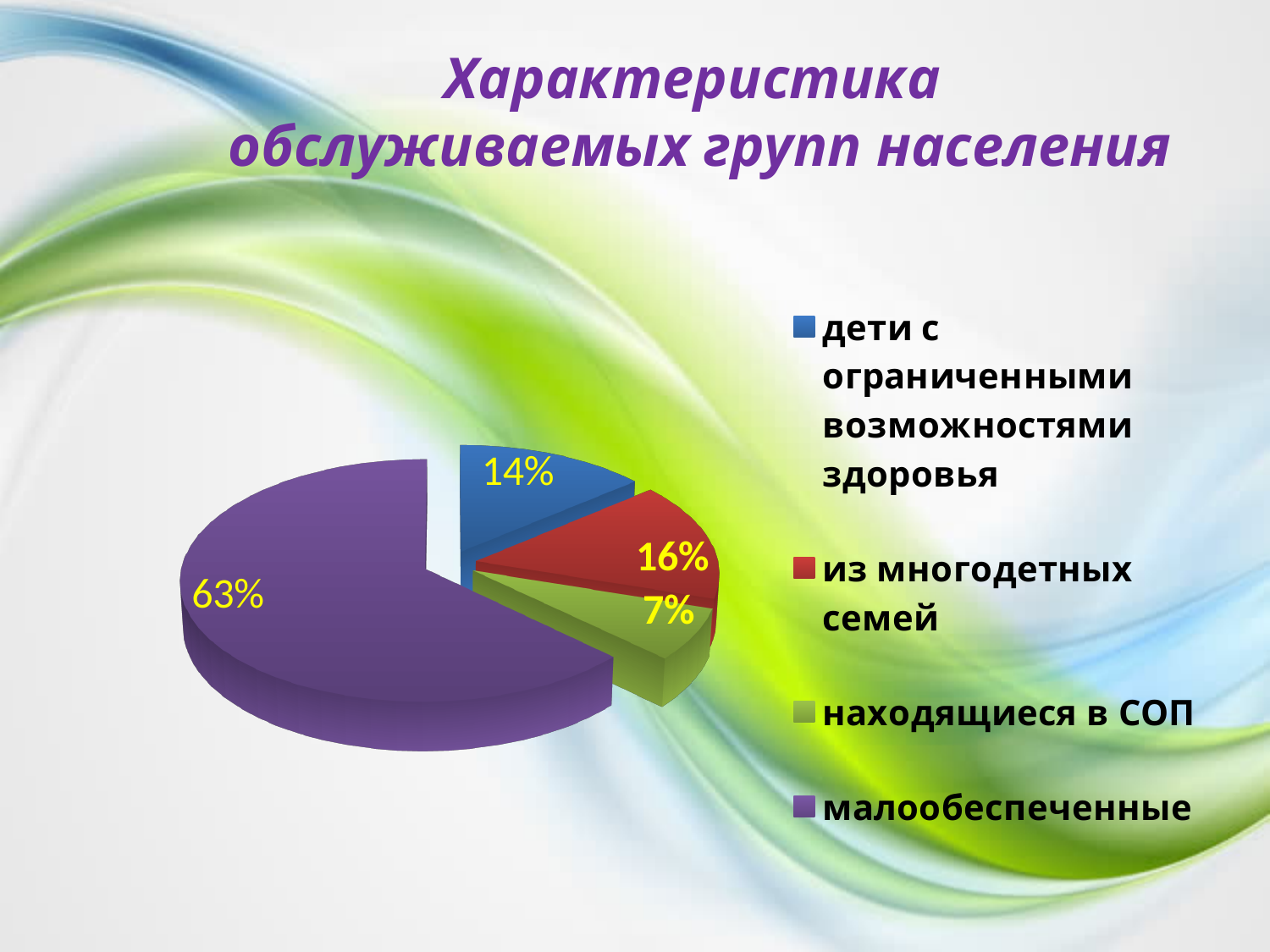
What share of the pie is labelled for "малообеспеченные"? 63% Which group has the smallest share of the pie? находящиеся в СОП What percentage is shown for "дети с ограниченными возможностями здоровья"? 14% What kind of chart is shown on the slide? Pie chart What percentage is shown for "находящиеся в СОП"? 7% How many slices does the pie chart have? 4 What is the difference in percentage points between "малооб��спеченные" and "из многодетных семей"? 47 What percentage is shown for "из многодетных семей"? 16% What colour is the slice for "малообеспеченные"? Purple How many entries does the legend list? 4 Which group has the largest share of the pie? малообеспеченные Which is larger: the share for "из многодетных семей" or the share for "дети с ограниченными возможностями здоровья"? из многодетных семей